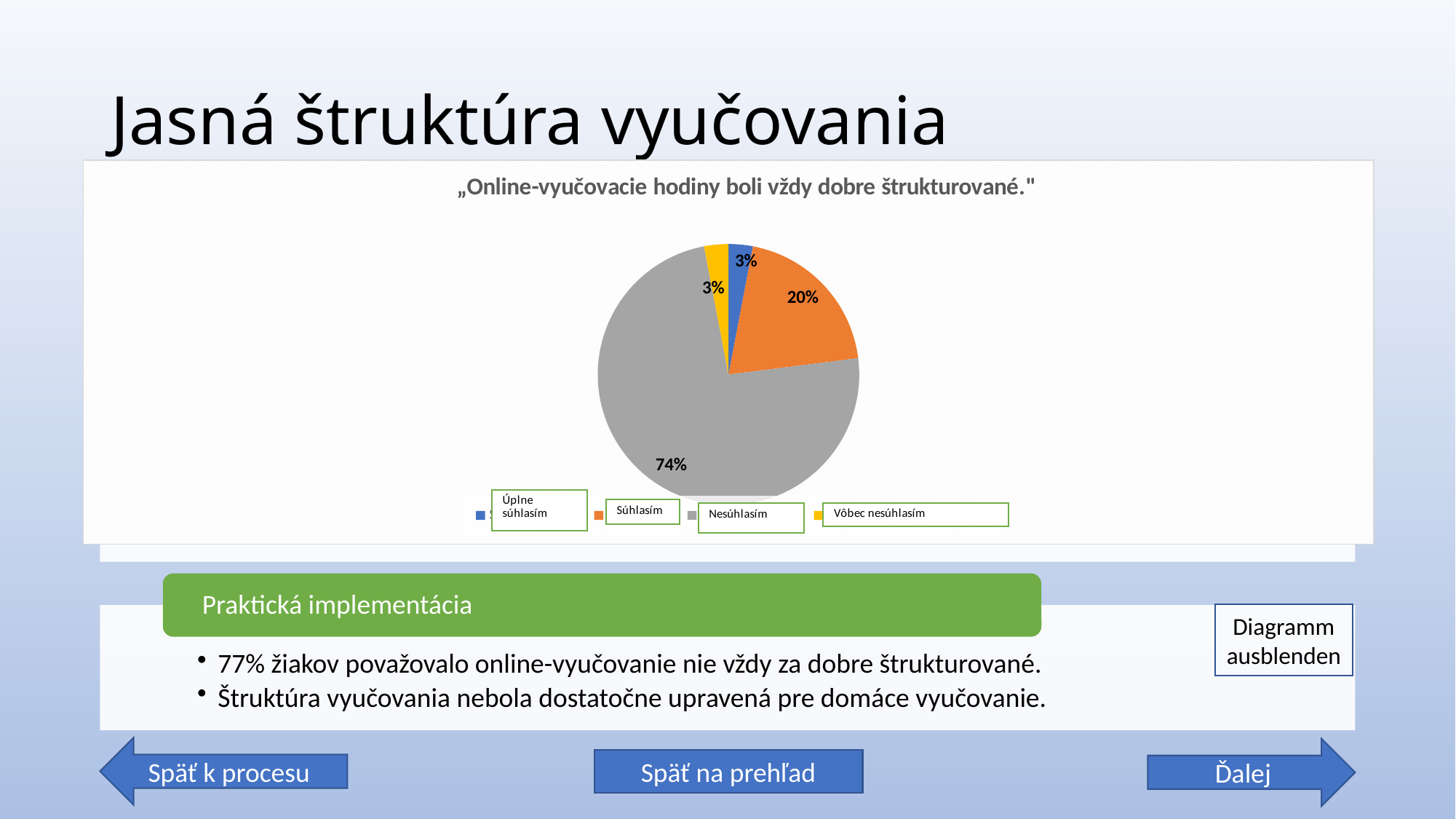
What percentage of the pie is labelled for Úplne súhlasím? 3% Which slice is larger, Súhlasím or Úplne súhlasím? Súhlasím What percentage of the pie is labelled for Vôbec nesúhlasím? 3% How many entries does the legend list? 4 What type of chart is shown on the slide? pie chart What colour is the Nesúhlasím slice? grey What percentage of the pie is labelled for Nesúhlasím? 74% Which category has the largest slice of the pie? Nesúhlasím What percentage of the pie is labelled for Súhlasím? 20% How many slices does the pie chart have? 4 What is the difference in percentage points between the Nesúhlasím slice and the Súhlasím slice? 54 What is the title of the chart? „Online-vyučovacie hodiny boli vždy dobre štrukturované."